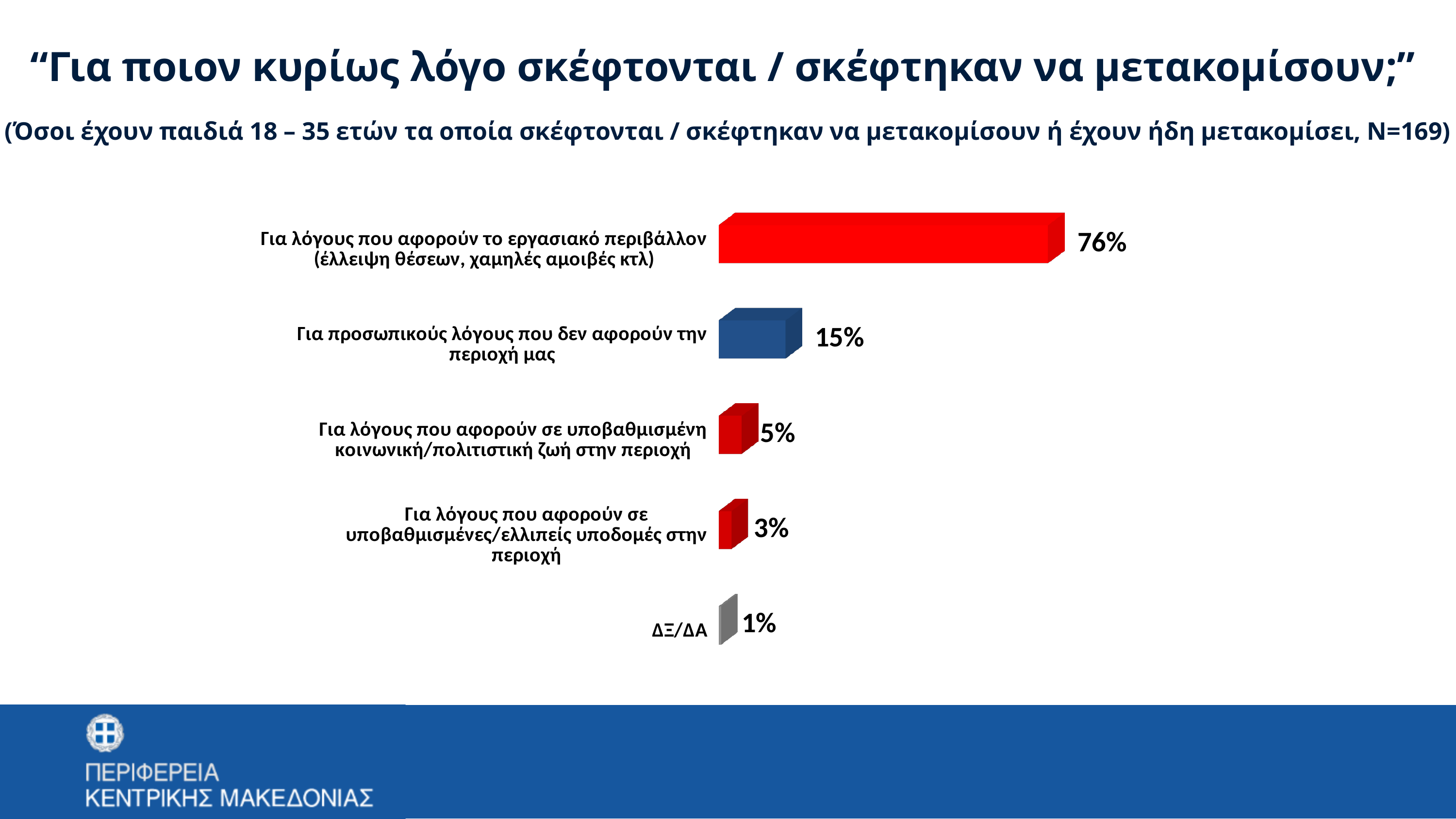
What percentage is shown for 'Για προσωπικούς λόγους που δεν αφορούν την περιοχή μας'? 15% Which category has the highest value? Για λόγους που αφορούν το εργασιακό περιβάλλον (έλλειψη θέσεων, χαμηλές αμοιβές κτλ) What is the difference between the value for 'Για λόγους που αφορούν το εργασιακό περιβάλλον' and the value for 'Για προσωπικούς λόγους που δεν αφορούν την περιοχή μας'? 61% How many categories are shown in the chart? 5 Which category has the lowest value? ΔΞ/ΔΑ What percentage is shown for 'Για λόγους που αφορούν σε υποβαθμισμένη κοινωνική/πολιτιστική ζωή στην περιοχή'? 5% Which is larger: the value for 'Για λόγους που αφορούν σε υποβαθμισμένη κοινωνική/πολιτιστική ζωή στην περιοχή' or the value for 'Για λόγους που αφορούν σε υποβαθμισμένες/ελλιπείς υποδομές στην περιοχή'? Για λόγους που αφορούν σε υποβαθμισμένη κοινωνική/πολιτιστική ζωή στην περιοχή What percentage is shown for 'Για λόγους που αφορούν το εργασιακό περιβάλλον (έλλειψη θέσεων, χαμηλές αμοιβές κτλ)'? 76% What percentage is shown for 'Για λόγους που αφορούν σε υποβαθμισμένες/ελλιπείς υποδομές στην περιοχή'? 3% What kind of chart is shown on the slide? Bar chart What is the sample size (N) stated in the subtitle of the slide? N=169 What percentage is shown for 'ΔΞ/ΔΑ'? 1%